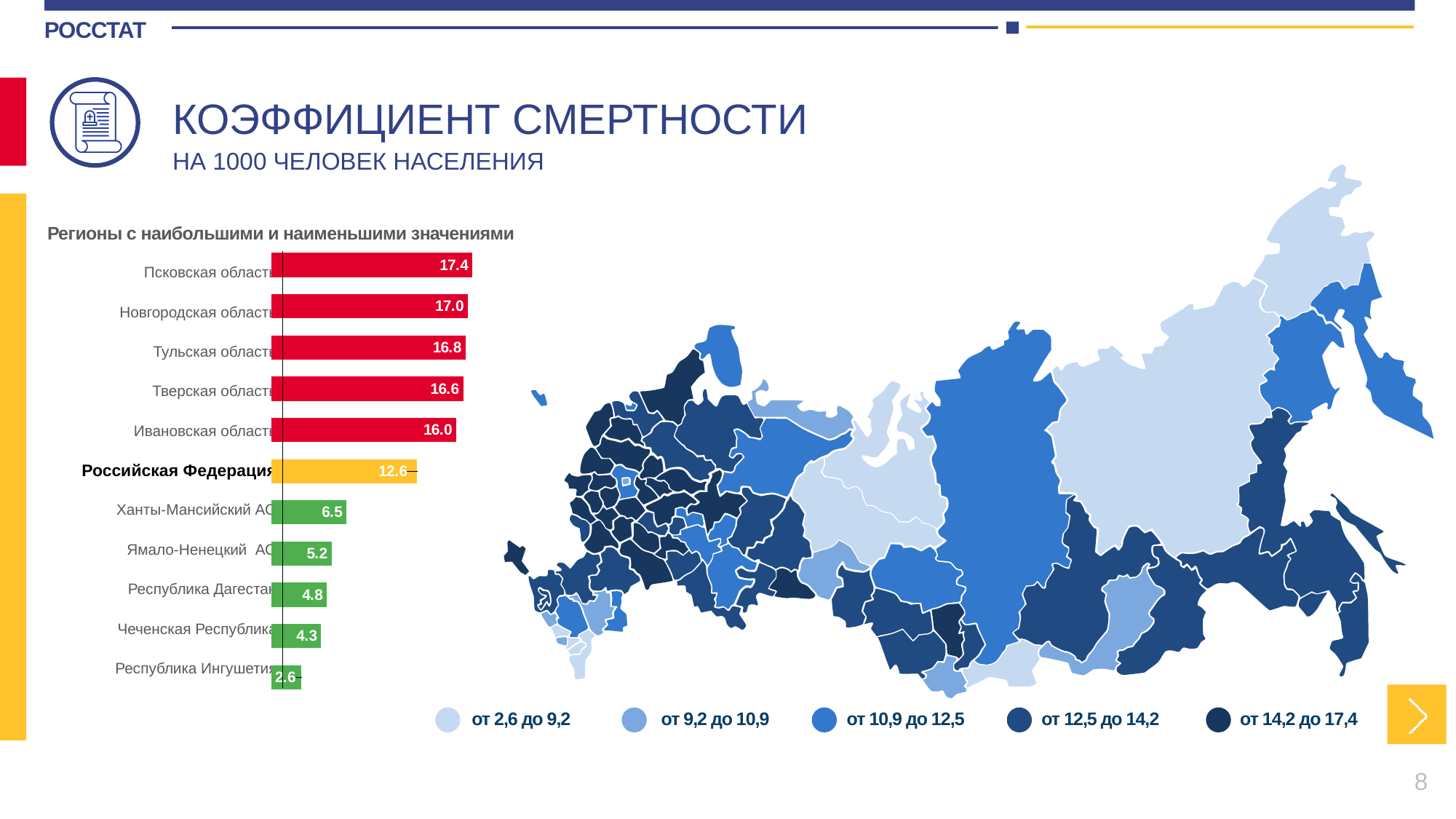
What is the value for Российская Федерация in the bar chart? 12.6 How many regions (bars) are shown in the bar chart? 11 What is the value for Псковская область in the bar chart? 17.4 Which region has the highest value in the bar chart? Псковская область What is the difference between the values for Псковская область and Республика Ингушетия? 14.8 What is the difference between the values for Новгородская область and Тульская область? 0.2 What is the value for Республика Дагестан in the bar chart? 4.8 Which region has the lowest value in the bar chart? Республика Ингушетия What kind of chart is used to show the regions with the highest and lowest values? bar chart How many value ranges does the map legend list? 5 Which is larger, the value for Ханты-Мансийский АО or the value for Ямало-Ненецкий АО? Ханты-Мансийский АО What is the value for Чеченская Республика in the bar chart? 4.3